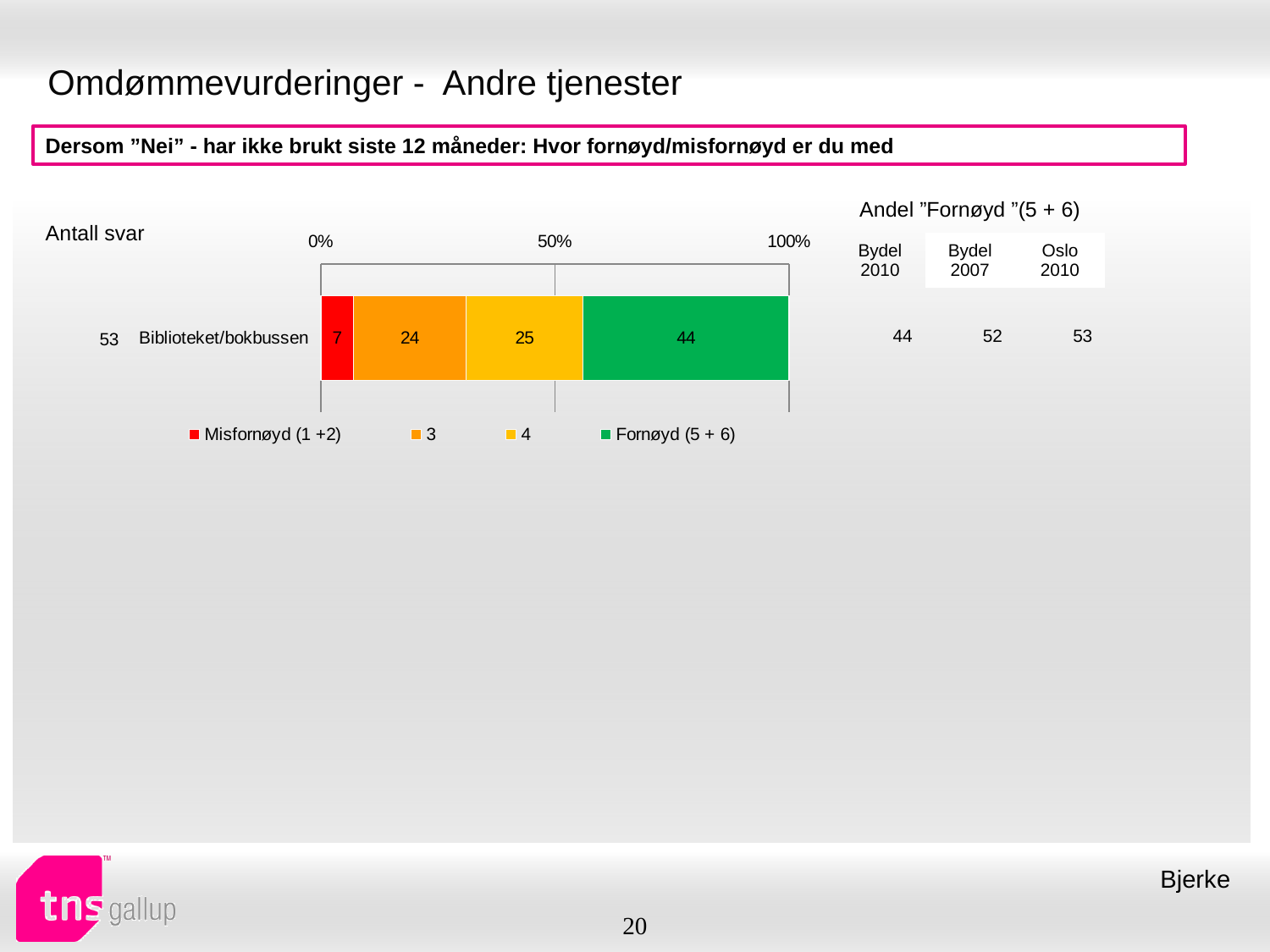
What is the value of the "3" segment for Biblioteket/bokbussen? 24 Which segment of the Biblioteket/bokbussen bar has the lowest value? Misfornøyd (1 +2) What is the value of the "4" segment for Biblioteket/bokbussen? 25 What is the difference between the "Fornøyd (5 + 6)" segment and the "Misfornøyd (1 +2)" segment for Biblioteket/bokbussen? 37 Which is larger for Biblioteket/bokbussen, the "3" segment or the "4" segment? 4 How many categories are plotted in the chart? 1 What is the value of the "Misfornøyd (1 +2)" segment for Biblioteket/bokbussen? 7 What is the value of the "Fornøyd (5 + 6)" segment for Biblioteket/bokbussen? 44 Which segment of the Biblioteket/bokbussen bar has the highest value? Fornøyd (5 + 6) How many series does the chart legend list? 4 What kind of chart is shown on the slide? Stacked bar chart What is the total of all segments in the Biblioteket/bokbussen bar? 100